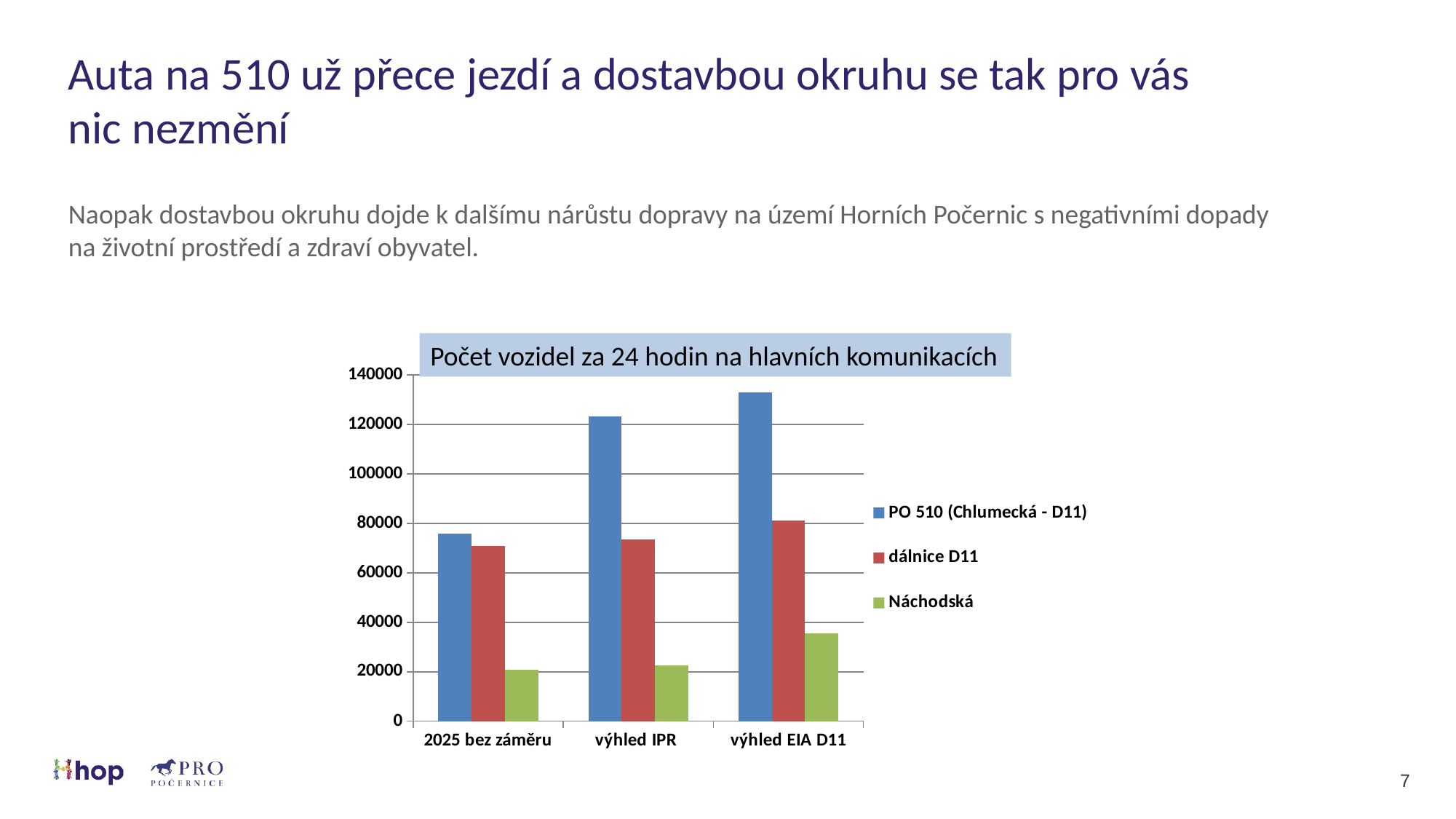
In výhled IPR, which is larger: PO 510 (Chlumecká - D11) or dálnice D11? PO 510 (Chlumecká - D11) Is the value for dálnice D11 in výhled EIA D11 greater or less than 100000? less In which category is the value for PO 510 (Chlumecká - D11) highest? výhled EIA D11 Is the value for PO 510 (Chlumecká - D11) in výhled EIA D11 greater or less than 120000? greater Which series is shown in green in the legend? Náchodská How many categories are shown on the x axis? 3 Is the value for Náchodská in 2025 bez záměru greater or less than 40000? less How many series does the legend list? 3 Do the values for PO 510 (Chlumecká - D11) rise or fall from 2025 bez záměru to výhled EIA D11? rise What is the title of the chart? Počet vozidel za 24 hodin na hlavních komunikacích In which category is the value for dálnice D11 highest? výhled EIA D11 What kind of chart is shown on the slide? bar chart